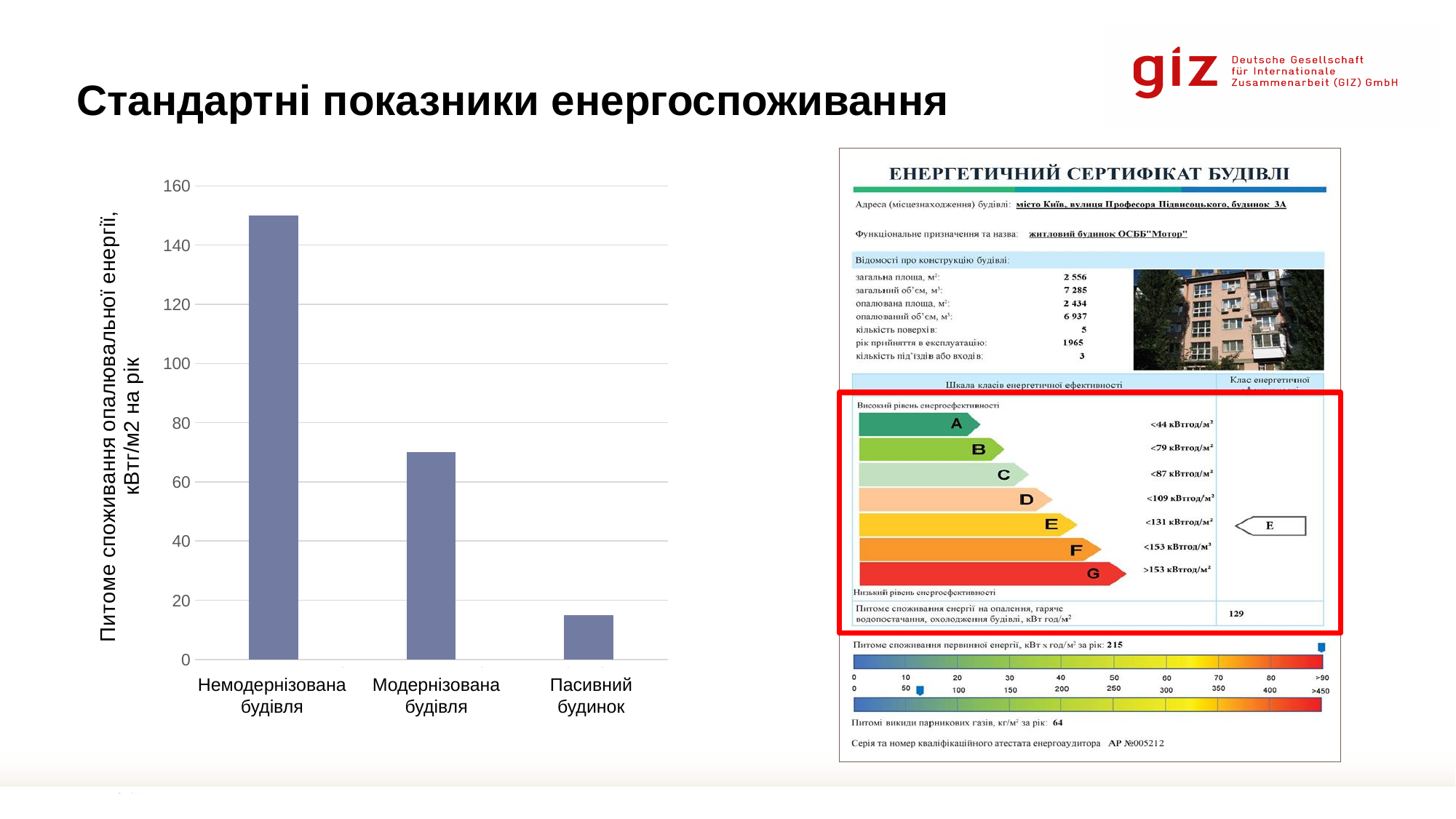
Which is larger in the bar chart: the value for Модернізована будівля or the value for Пасивний будинок? Модернізована будівля Is the value for Модернізована будівля greater or less than 80? less Which category has the lowest value in the bar chart? Пасивний будинок What kind of chart is shown on the left of the slide? bar chart What is the highest tick value shown on the y axis of the bar chart? 160 Which category has the highest value in the bar chart? Немодернізована будівля What is the label of the y axis of the bar chart? Питоме споживання опалювальної енергії, кВтг/м2 на рік Do the values in the bar chart rise or fall from left to right along the x axis? fall Is the value for Пасивний будинок greater or less than 20? less How many categories are shown on the x axis of the bar chart? 3 Is the value for Немодернізована будівля greater or less than 140? greater